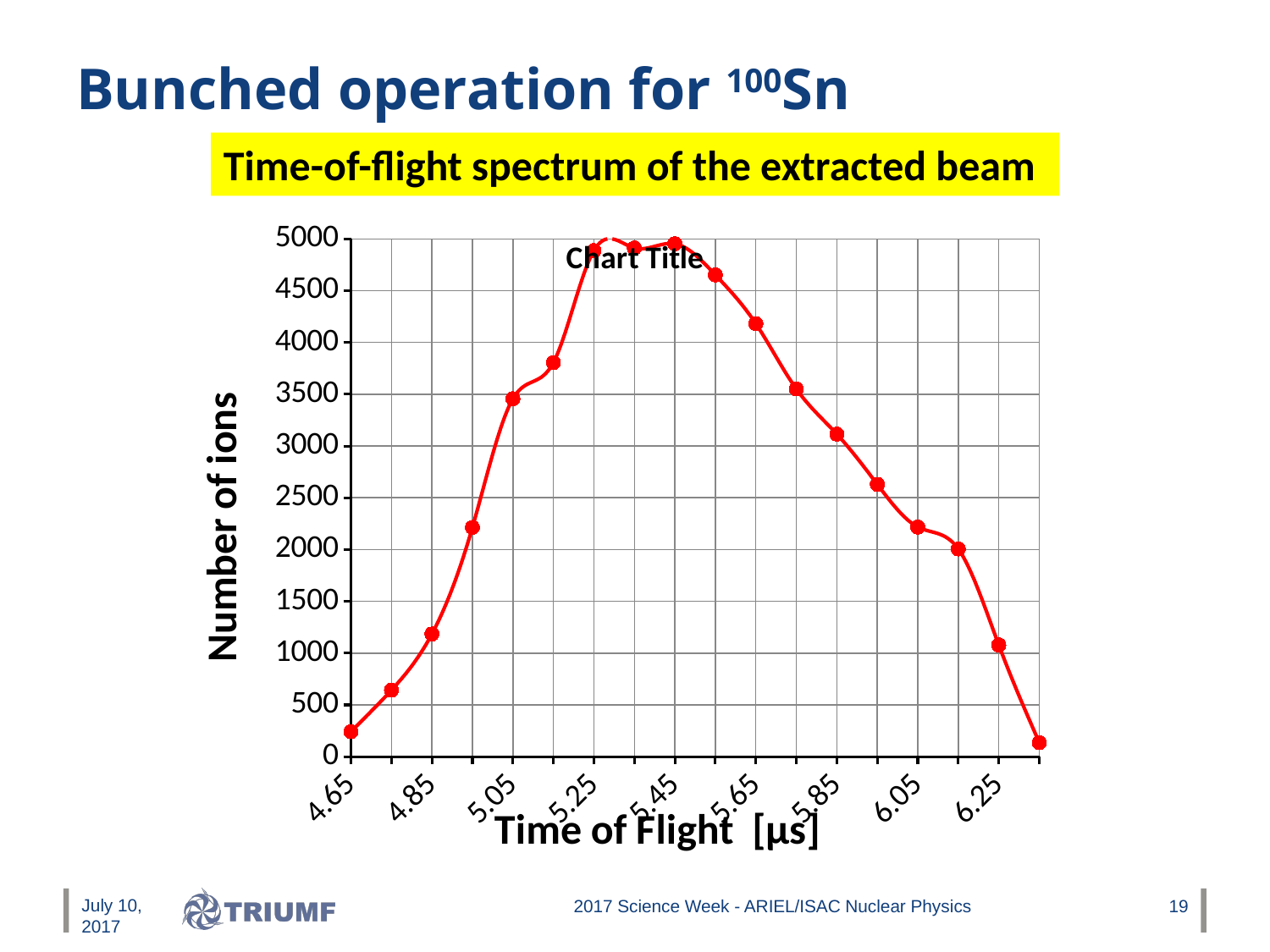
Which has more ions: a time of flight of 5.05 µs or 6.05 µs? 5.05 Does the number of ions rise or fall as the time of flight increases from 4.65 µs to 5.45 µs? rise Is the number of ions at a time of flight of 4.65 µs greater or less than 500? less Does the number of ions rise or fall as the time of flight increases from 5.45 µs to 6.25 µs? fall Is the number of ions at a time of flight of 5.65 µs greater or less than 4000? greater Which has more ions: a time of flight of 4.65 µs or 6.25 µs? 6.25 Is the number of ions at a time of flight of 5.05 µs greater or less than 3000? greater What kind of chart is shown on the slide? line chart What is the title of the x axis of the chart? Time of Flight [µs] What is the title of the y axis of the chart? Number of ions